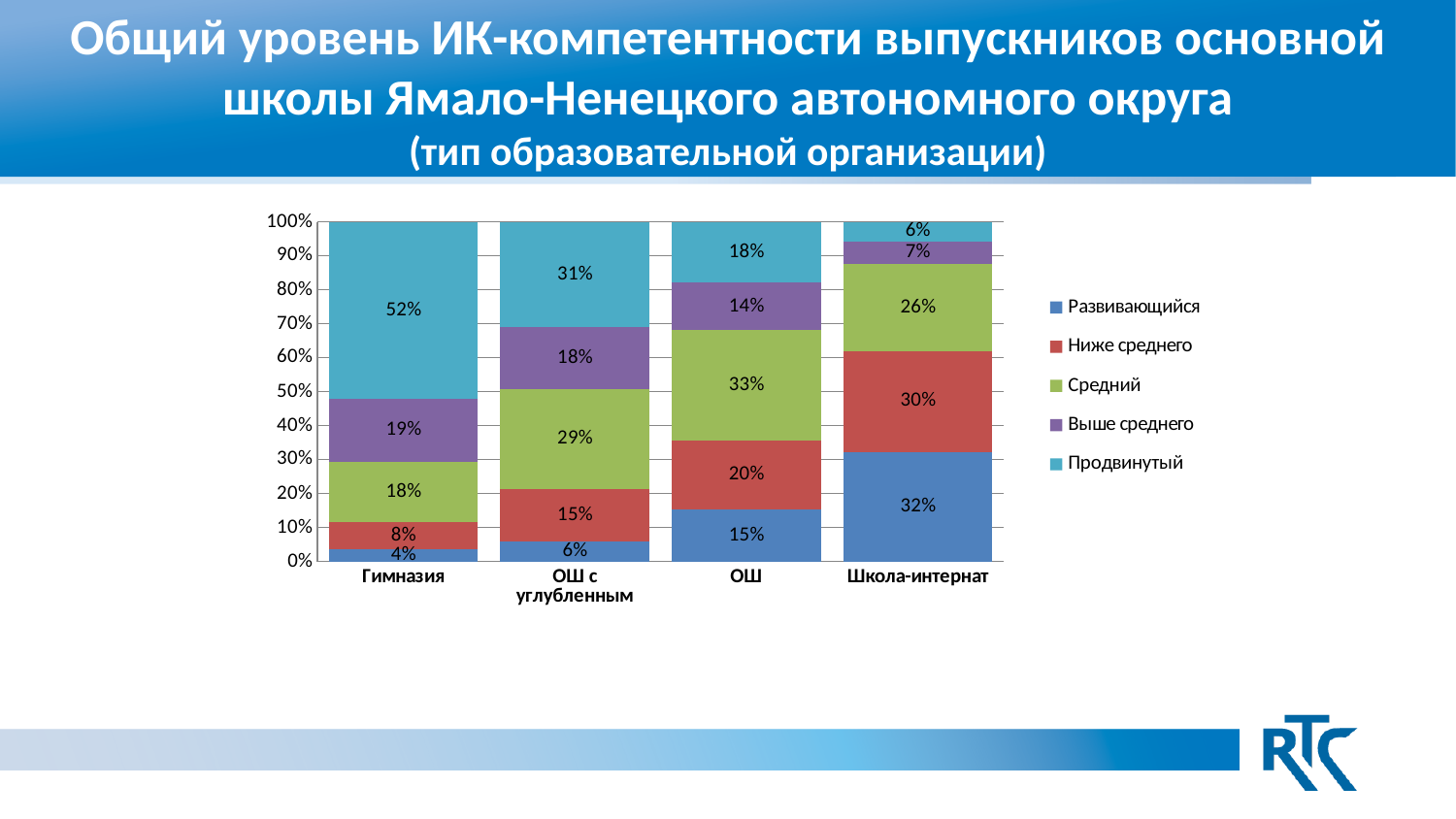
What is the value of the Развивающийся segment for Школа-интернат? 32% Which is larger: the Средний value for ОШ or the Средний value for Школа-интернат? ОШ How many categories are shown on the x axis? 4 What is the value of the Продвинутый segment for Гимназия? 52% Which category has the highest Продвинутый value? Гимназия How many series does the legend list? 5 What kind of chart is shown on the slide? Stacked bar chart What is the value of the Ниже среднего segment for ОШ с углубленным? 15% Which legend entry is shown in green? Средний What is the value of the Средний segment for ОШ? 33% What is the difference between the Продвинутый values for Гимназия and Школа-интернат? 46% Which category has the lowest Развивающийся value? Гимназия